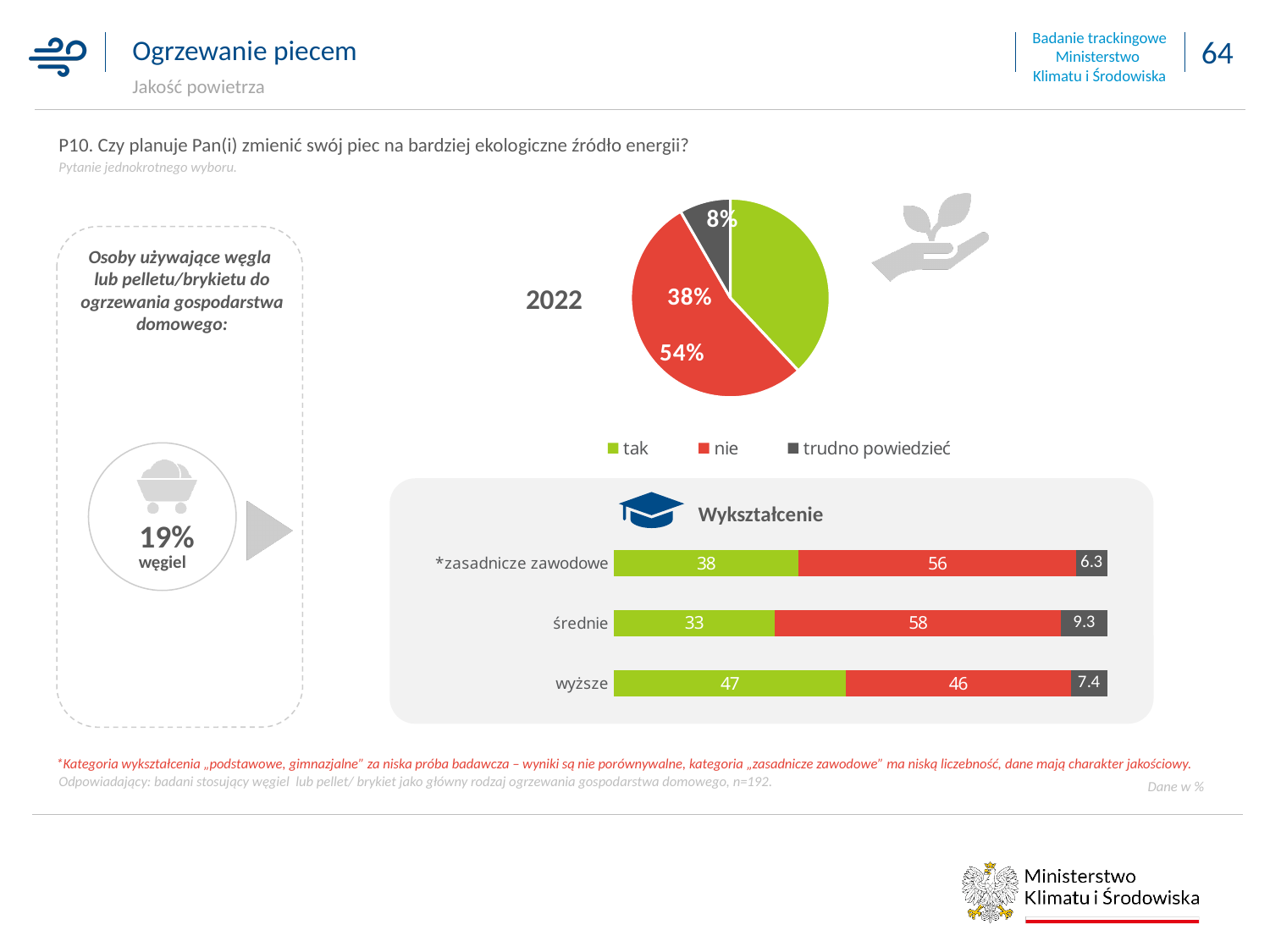
How many entries does the legend of the 2022 pie chart list? 3 In the Wykształcenie bar chart, what is the value of "trudno powiedzieć" for zasadnicze zawodowe? 6.3 In the Wykształcenie bar chart, what is the value of "tak" for wyższe? 47 In the 2022 pie chart, what percentage of respondents answered "trudno powiedzieć"? 8% What kind of chart is the 2022 chart at the top of the slide? pie chart In the 2022 pie chart, which answer has the largest share? nie In the 2022 pie chart, what percentage of respondents answered "nie"? 54% In the 2022 pie chart, what percentage of respondents answered "tak"? 38% How many education categories are shown in the Wykształcenie bar chart? 3 In the Wykształcenie bar chart, what is the value of "nie" for średnie? 58 In the Wykształcenie bar chart, what is the difference between the "nie" value for średnie and the "nie" value for wyższe? 12 In the Wykształcenie bar chart, which education level has the highest value for "tak"? wyższe